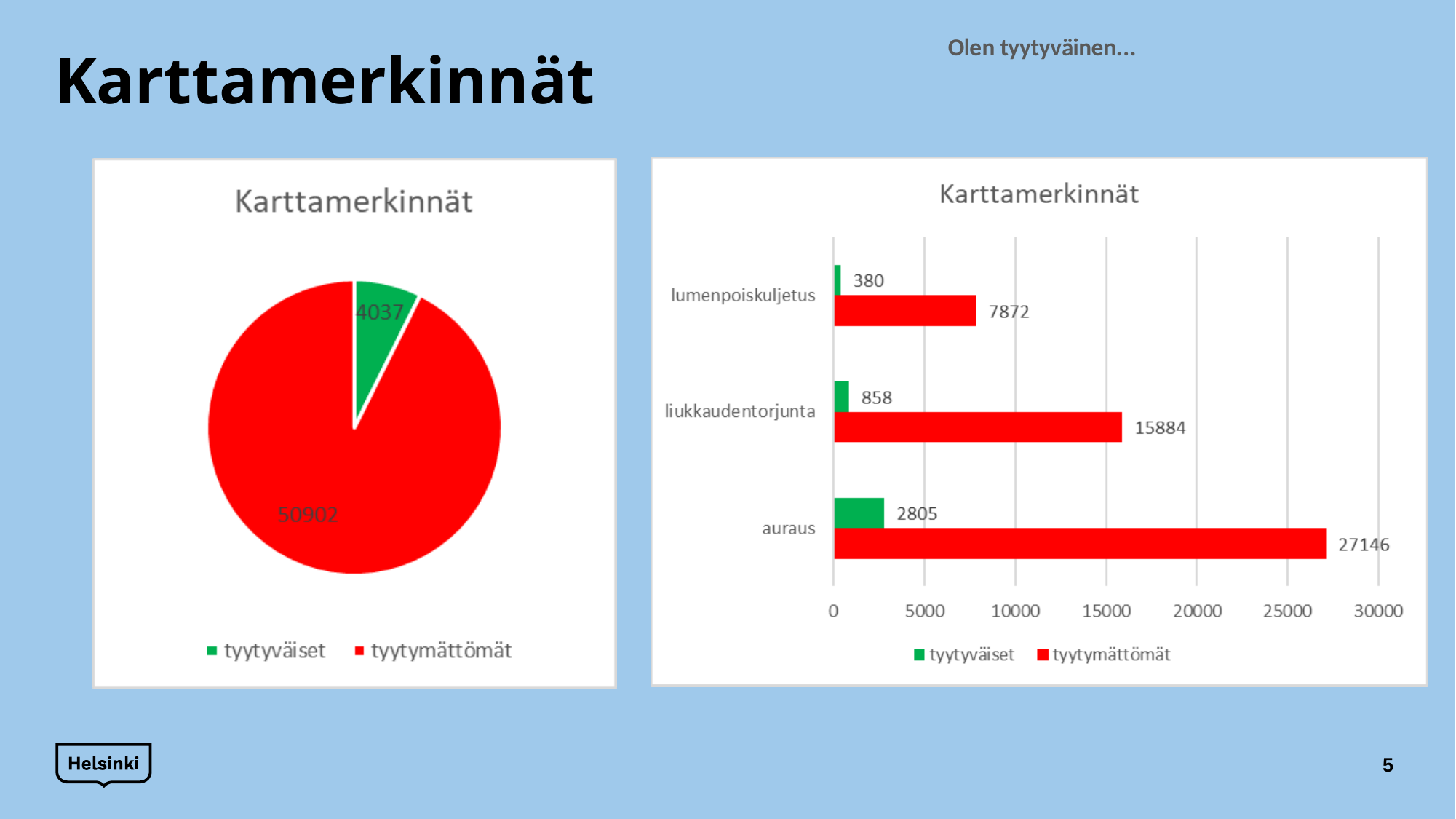
What type of chart is the chart on the left side of the slide? pie chart How many categories are shown in the bar chart on the right? 3 In the bar chart on the right, what is the tyytymättömät value for auraus? 27146 In the bar chart on the right, what is the tyytymättömät value for liukkaudentorjunta? 15884 In the pie chart on the left, which slice is larger, tyytyväiset or tyytymättömät? tyytymättömät What type of chart is the chart on the right side of the slide? bar chart In the bar chart on the right, what is the tyytyväiset value for lumenpoiskuljetus? 380 In the pie chart on the left, what is the value for tyytyväiset? 4037 In the bar chart on the right, which category has the lowest tyytymättömät value? lumenpoiskuljetus In the bar chart on the right, which category has the highest tyytyväiset value? auraus In the pie chart on the left, what is the value for tyytymättömät? 50902 In the bar chart on the right, what is the difference between the tyytymättömät and tyytyväiset values for auraus? 24341